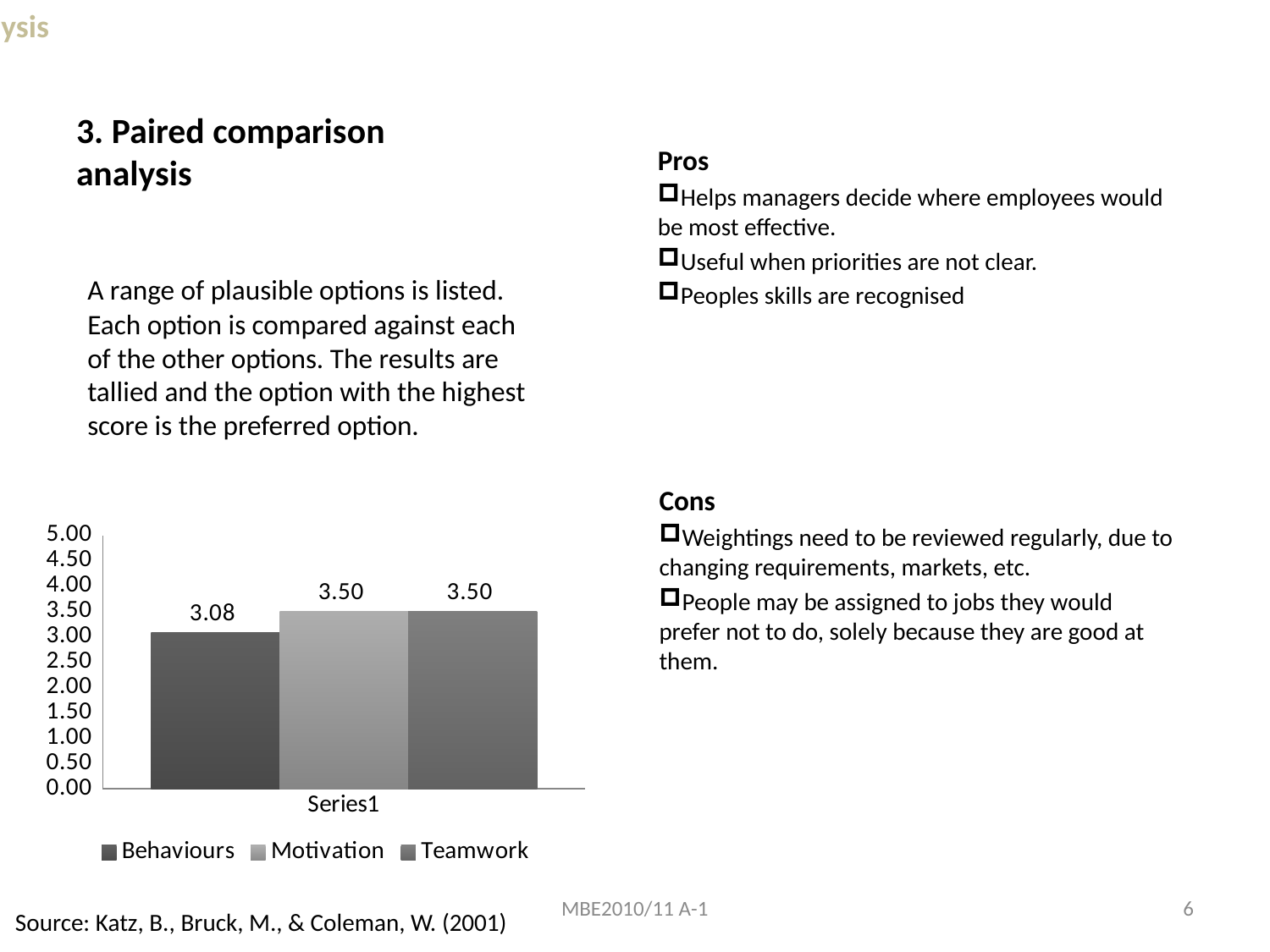
What is the value for Motivation in the bar chart? 3.50 What is the value for Teamwork in the bar chart? 3.50 What is the value for Behaviours in the bar chart? 3.08 What kind of chart is shown on the slide? bar chart Is the value for Behaviours in the bar chart greater or less than 3.00? greater How many categories are shown on the x axis of the bar chart? 1 How many series does the legend of the bar chart list? 3 Which is larger in the bar chart, the value for Behaviours or the value for Teamwork? Teamwork Is the value for Motivation in the bar chart greater or less than 4.00? less Which series has the lowest value in the bar chart? Behaviours What is the label shown on the x axis of the bar chart? Series1 What is the difference between the Motivation value and the Behaviours value in the bar chart? 0.42